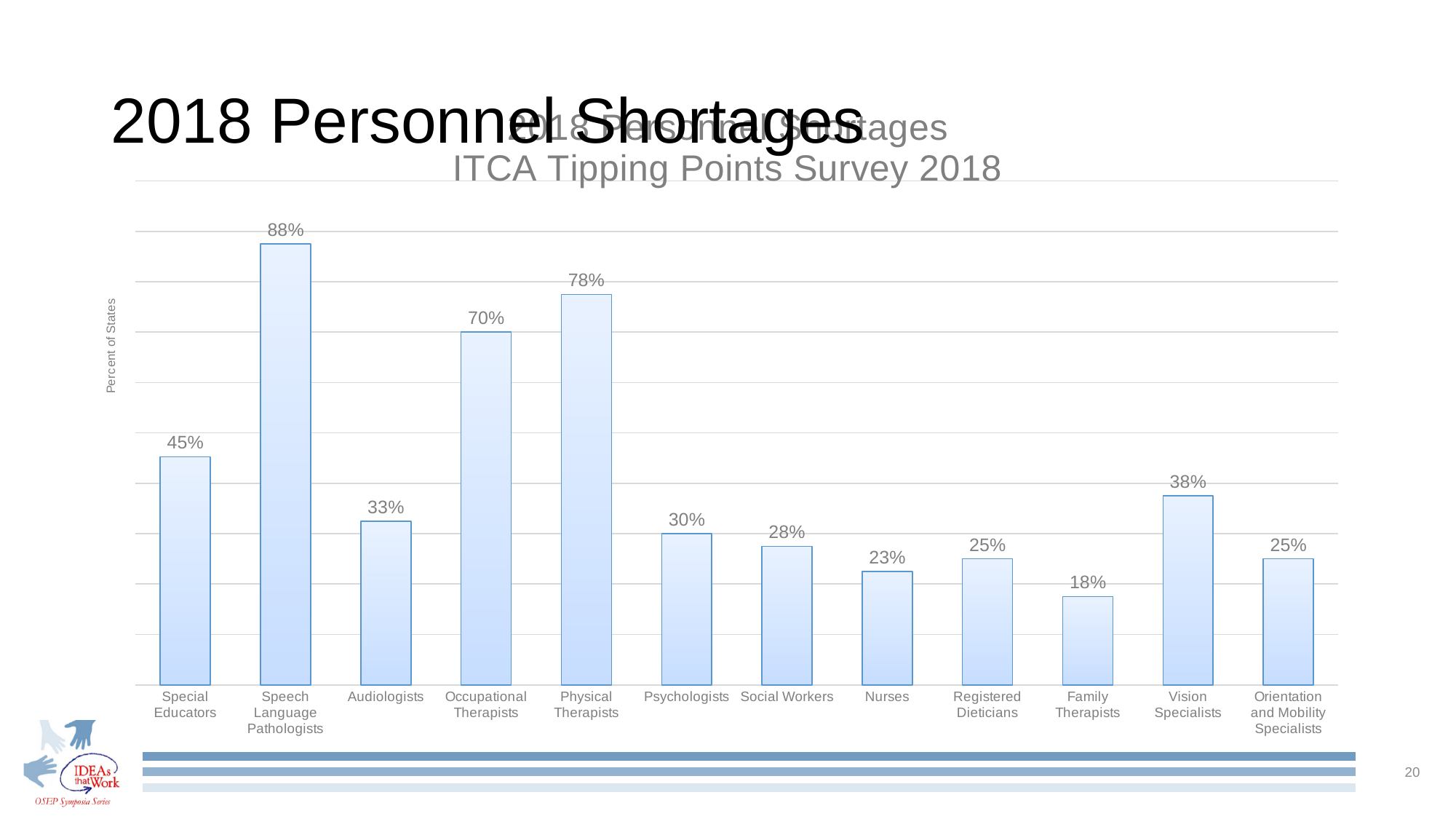
What is the difference between the values for Physical Therapists and Occupational Therapists? 8% What is the value for Vision Specialists? 38% Which is larger, the value for Psychologists or the value for Social Workers? Psychologists Which category has the highest value? Speech Language Pathologists Which is larger, the value for Vision Specialists or the value for Special Educators? Special Educators What is the difference between the values for Special Educators and Audiologists? 12% Which category has the lowest value? Family Therapists How many categories are shown on the x axis? 12 What is the label of the vertical axis? Percent of States What kind of chart is shown on the slide? Bar chart What is the value for Speech Language Pathologists? 88% What is the value for Nurses? 23%